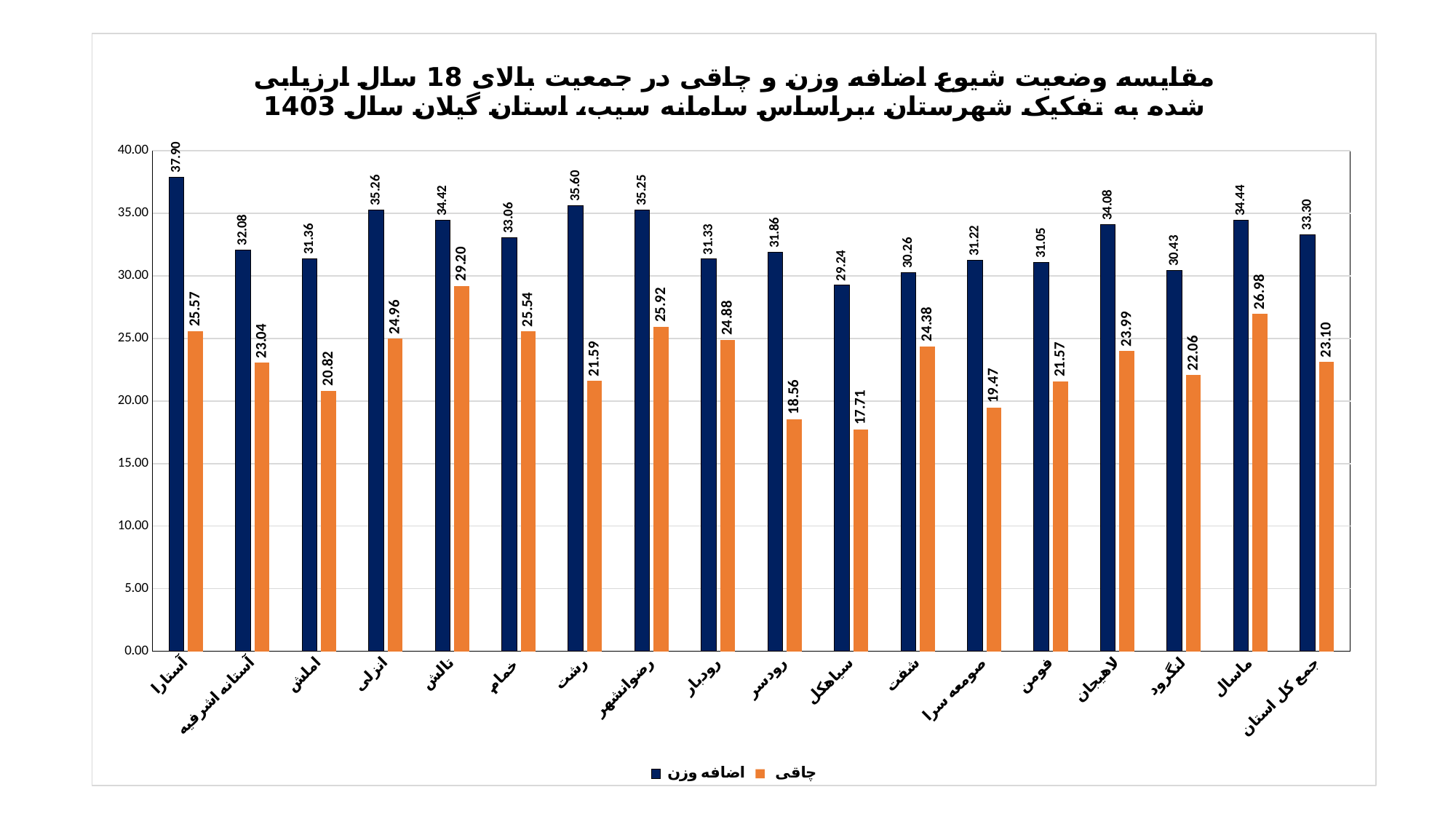
What is the value of چاقی for جمع کل استان? 23.10 What is the difference between the اضافه وزن and چاقی values for رشت? 14.01 What type of chart is shown on the slide? bar chart Which category has the lowest value for چاقی? سیاهکل Which category has the highest value for چاقی? تالش Which category has the highest value for اضافه وزن? آستارا Which series is shown in orange in the legend? چاقی How many series does the legend list? 2 What is the value of چاقی for تالش? 29.20 Which is larger, the چاقی value for ماسال or the چاقی value for لاهیجان? ماسال What is the value of اضافه وزن for آستارا? 37.90 How many categories are shown on the x axis? 18